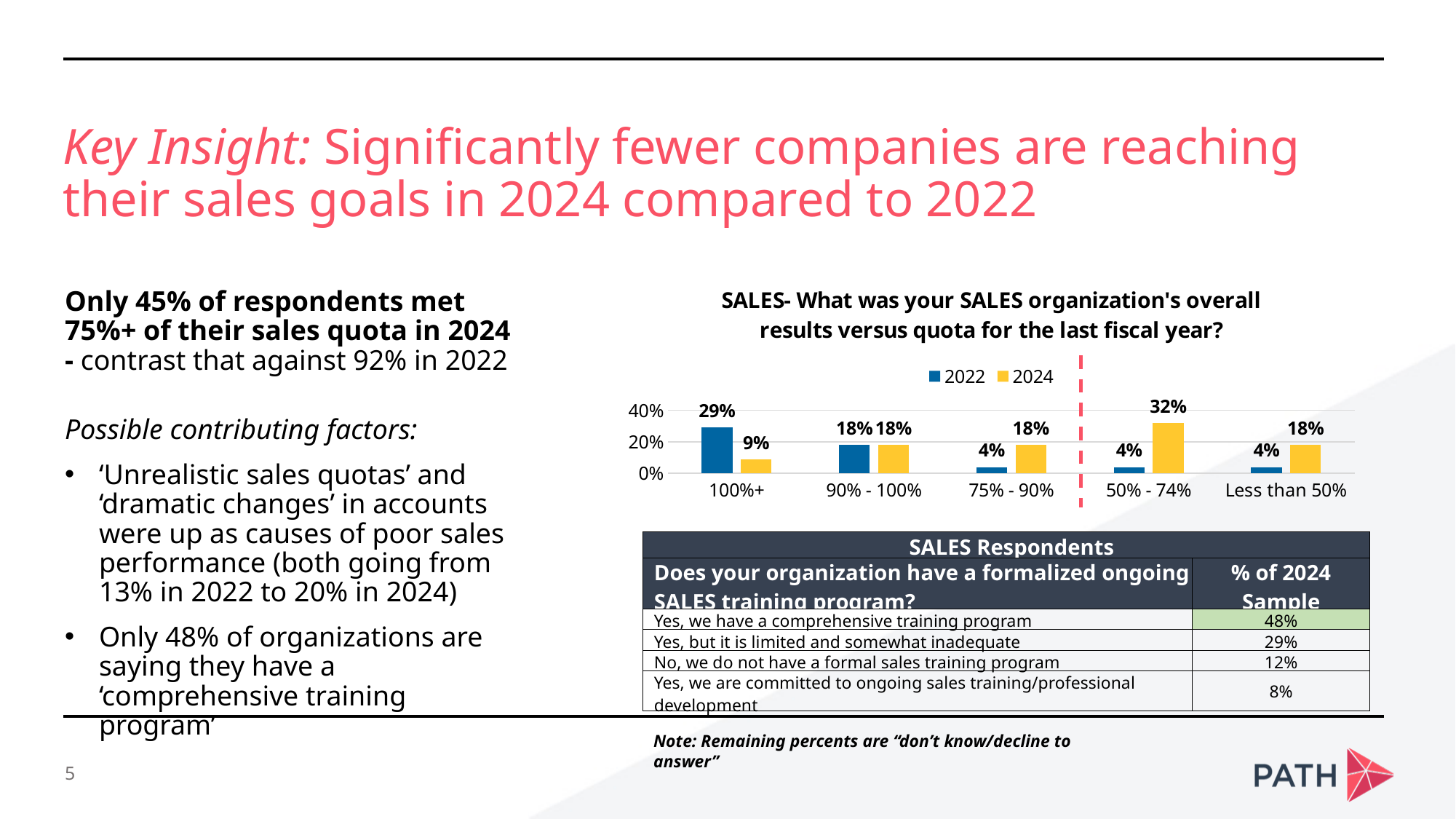
Which is larger for the 75% - 90% category, the 2022 value or the 2024 value? 2024 Which category has the highest 2024 value? 50% - 74% What is the 2024 value for the 100%+ category? 9% What type of chart is shown on the slide? Bar chart What is the 2022 value for the Less than 50% category? 4% Which category has the highest 2022 value? 100%+ What is the difference between the 2024 and 2022 values for the 50% - 74% category? 28% How many categories are shown on the x axis of the chart? 5 How many series does the chart legend list? 2 What is the 2022 value for the 100%+ category? 29% What is the difference between the 2022 and 2024 values for the 100%+ category? 20% What is the 2024 value for the 50% - 74% category? 32%